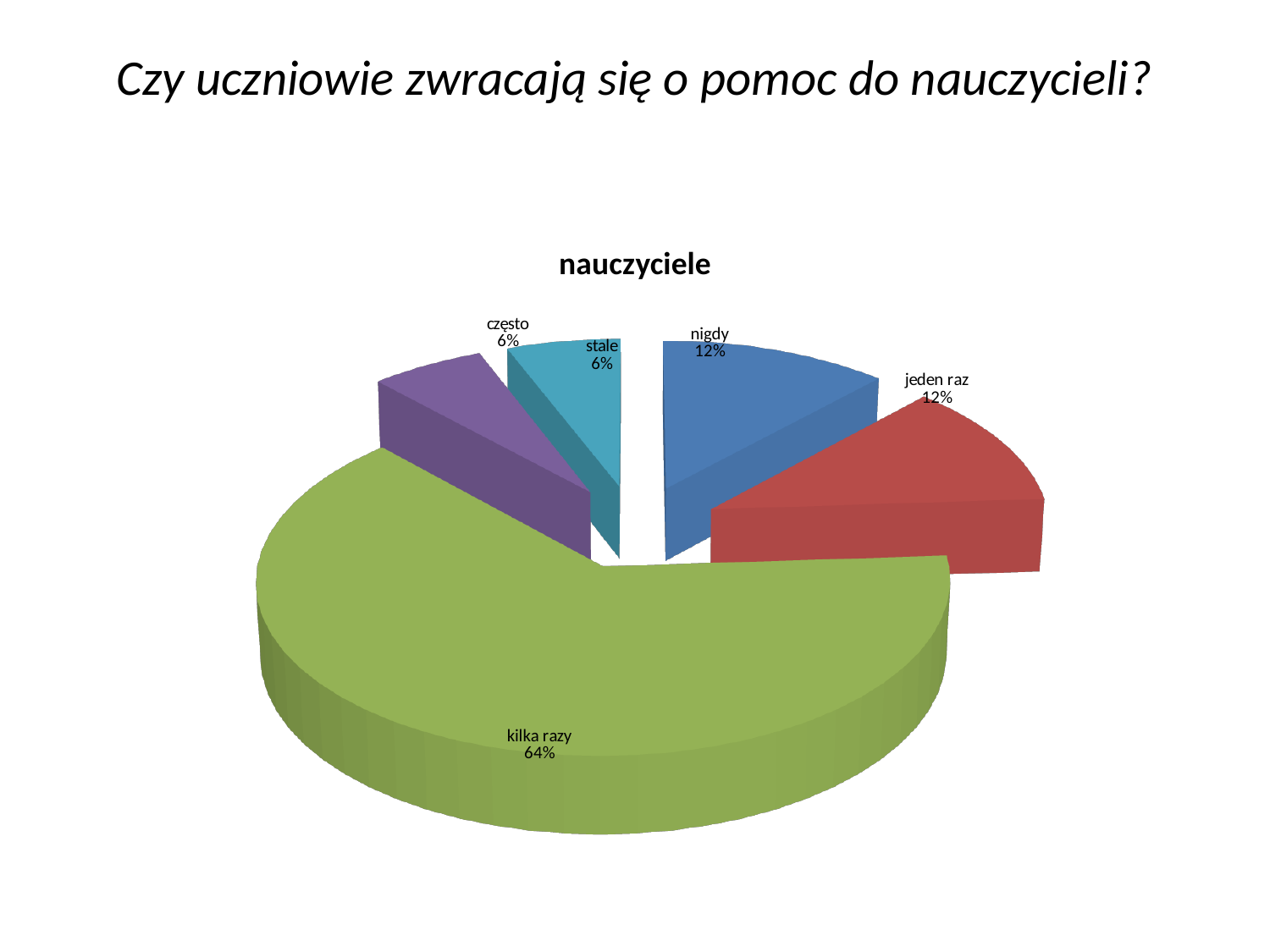
How many slices does the pie chart have? 5 What is the title of the chart? nauczyciele Which is larger, the share for 'jeden raz' or the share for 'stale'? jeden raz What share of the pie does 'kilka razy' take? 64% What colour is the 'kilka razy' slice? green Which category has the largest slice of the pie? kilka razy What is the value for 'stale'? 6% What kind of chart is shown on the slide? pie chart What is the difference between the shares of 'kilka razy' and 'nigdy'? 52% What is the value for 'nigdy'? 12% What is the value for 'jeden raz'? 12% What is the value for 'często'? 6%